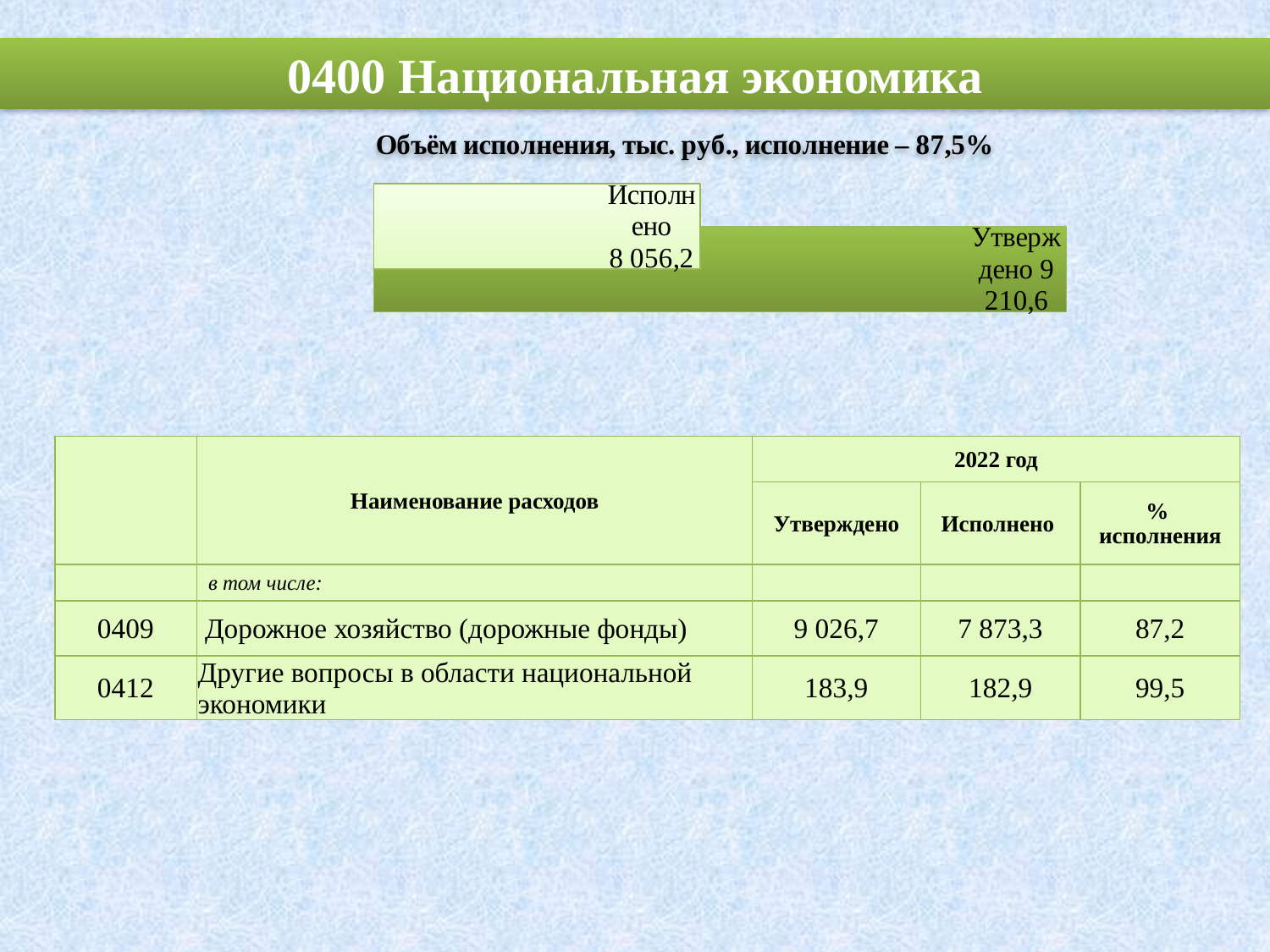
What is the value of the bar labelled "Утверждено"? 9 210,6 What execution percentage is stated in the chart title? 87,5% What is the difference between the "Утверждено" value and the "Исполнено" value? 1 154,4 What is the value of the bar labelled "Исполнено"? 8 056,2 What is the title of the chart? Объём исполнения, тыс. руб., исполнение – 87,5% How many bars are plotted in the chart? 2 What kind of chart is shown on the slide? bar chart Which bar has the lowest value in the chart? Исполнено Is the value for "Исполнено" larger or smaller than the value for "Утверждено"? smaller Which bar has the higher value, "Исполнено" or "Утверждено"? Утверждено